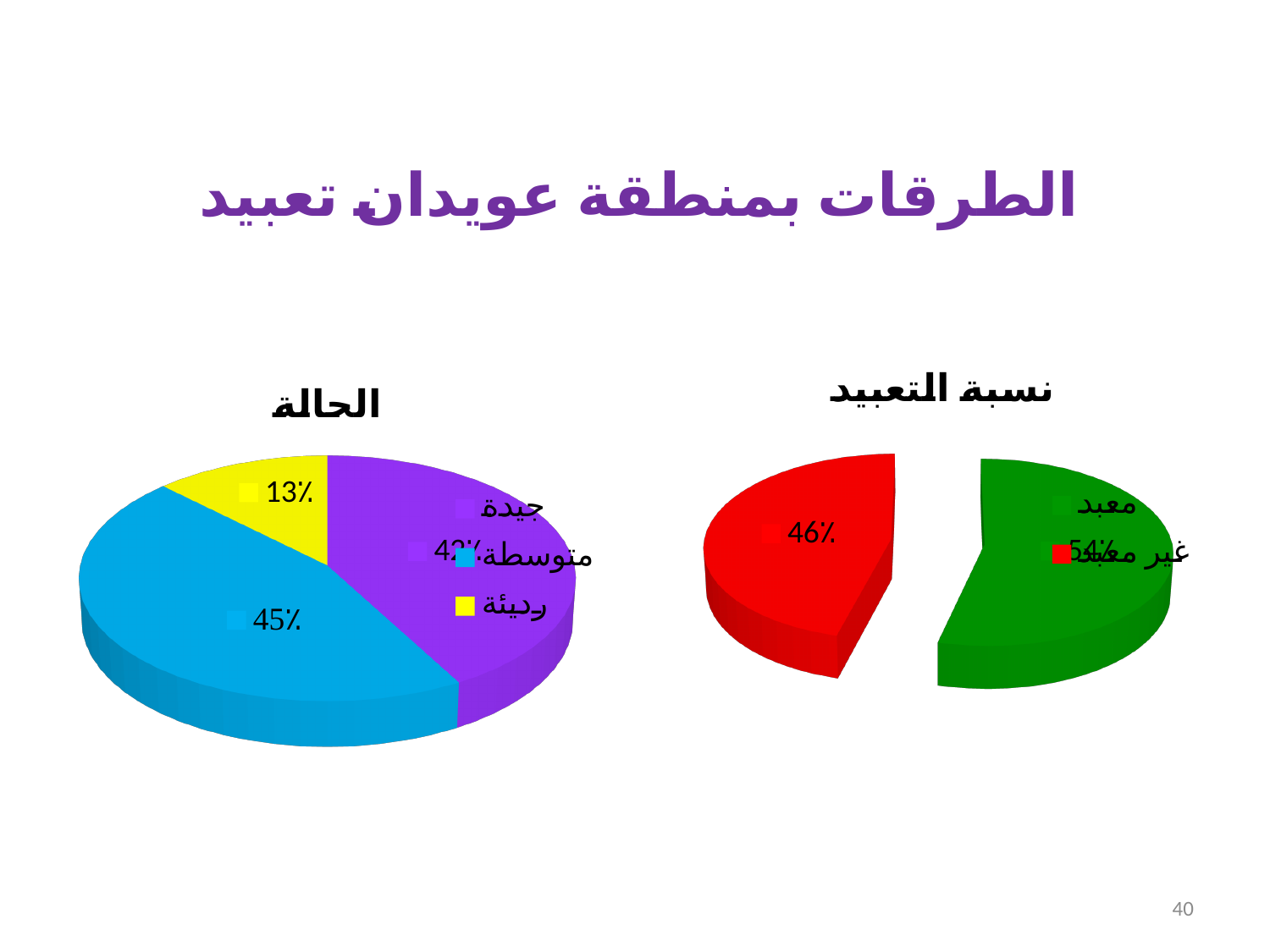
In the chart titled "الحالة", what percentage is shown for the blue slice (متوسطة)? 45% In the chart titled "الحالة", what percentage is shown for the yellow slice (رديئة)? 13% What type of chart is the chart titled "نسبة التعبيد"? Pie chart In the chart titled "الحالة", what is the difference in percentage points between the متوسطة slice and the رديئة slice? 32 In the chart titled "نسبة التعبيد", which slice is larger, the green one (معبد) or the red one (غير معبد)? معبد In the chart titled "نسبة التعبيد", what percentage is shown for the red slice (غير معبد)? 46% In the chart titled "الحالة", which category has the smallest share? رديئة In the chart titled "الحالة", how many slices does the pie have? 3 In the chart titled "الحالة", which category has the largest share? متوسطة In the chart titled "الحالة", what percentage is shown for the purple slice (جيدة)? 42% In the chart titled "نسبة التعبيد", how many categories does the legend list? 2 In the chart titled "الحالة", what colour is the slice for جيدة? Purple